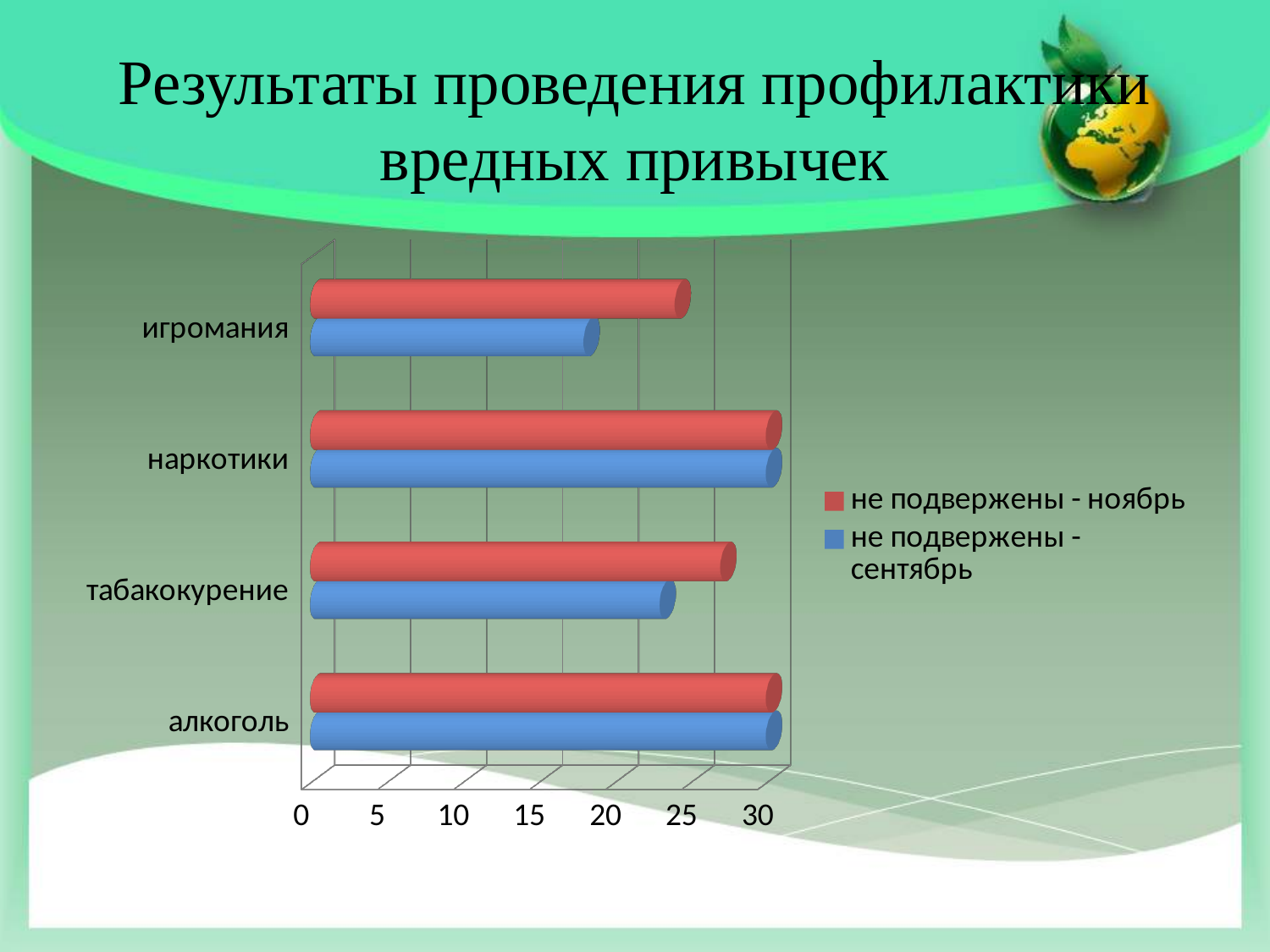
How many categories are shown on the chart? 4 Which category has the lowest value for the series "не подвержены - сентябрь"? игромания Which colour represents the series "не подвержены - сентябрь" in the chart? blue What is the title of the slide containing the chart? Результаты проведения профилактики вредных привычек Is the value for "алкоголь" in the series "не подвержены - ноябрь" greater or less than 25? greater For the category "игромания", which series has the larger value: "не подвержены - ноябрь" or "не подвержены - сентябрь"? не подвержены - ноябрь Is the value for "игромания" in the series "не подвержены - сентябрь" greater or less than 25? less What kind of chart is shown on the slide? bar chart Which category has the lowest value for the series "не подвержены - ноябрь"? игромания For the category "табакокурение", which series has the larger value: "не подвержены - ноябрь" or "не подвержены - сентябрь"? не подвержены - ноябрь How many series does the legend list? 2 Is the value for "табакокурение" in the series "не подвержены - ноябрь" greater or less than 25? greater